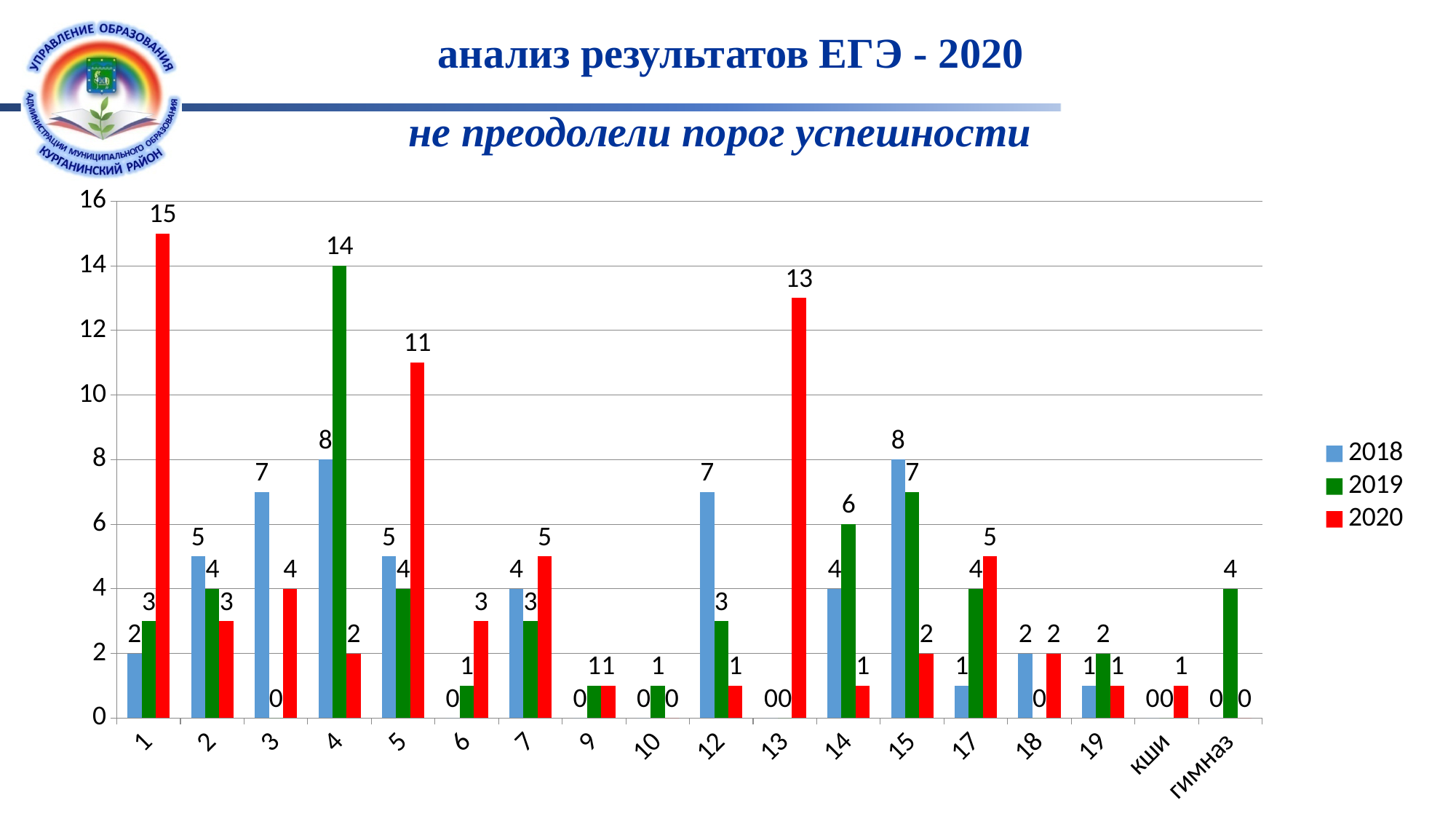
Which is larger for category 5: the 2018 value or the 2020 value? 2020 How many series does the legend list? 3 What is the value for category 1 in the 2020 series? 15 What is the difference between the 2020 and 2018 values for category 13? 13 What is the total of the 2018, 2019 and 2020 values for category 2? 12 Which category has the highest value in the 2020 series? 1 How many categories are shown on the x axis? 18 What kind of chart is shown on the slide? bar chart What is the value for category 15 in the 2018 series? 8 What is the value for category 4 in the 2019 series? 14 Which colour represents the 2019 series in the legend? green Which category has the highest value in the 2019 series? 4